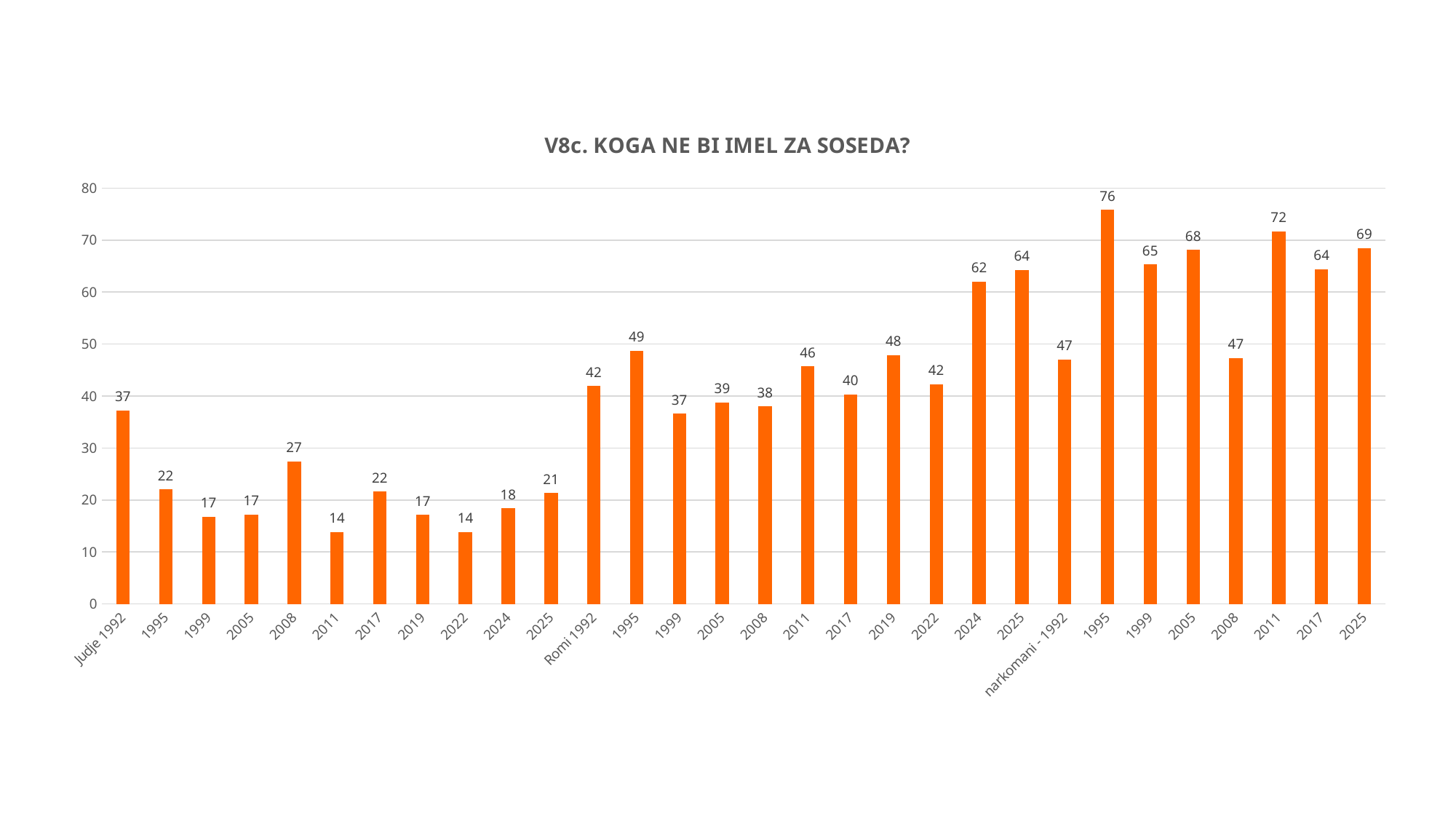
What is the value of the bar labelled 'Romi 1992'? 42 What is the value of the bar labelled 'Judje 1992'? 37 Which is larger: the 'Romi 1992' bar or the 'Judje 1992' bar? Romi 1992 Which bar has the highest value on the chart? 1995 in the narkomani group (76) How many bars are plotted on the chart? 30 What is the difference between the 'narkomani - 1992' bar (47) and the 'Judje 1992' bar (37)? 10 What is the title of the chart? V8c. KOGA NE BI IMEL ZA SOSEDA? What is the value of the 2025 bar in the Romi group (the last bar before 'narkomani - 1992')? 64 What is the value of the bar labelled 'narkomani - 1992'? 47 Is the value of the 'narkomani - 1992' bar greater or less than 40? greater What is the lowest value shown on the chart? 14 What kind of chart is shown on the slide? bar chart